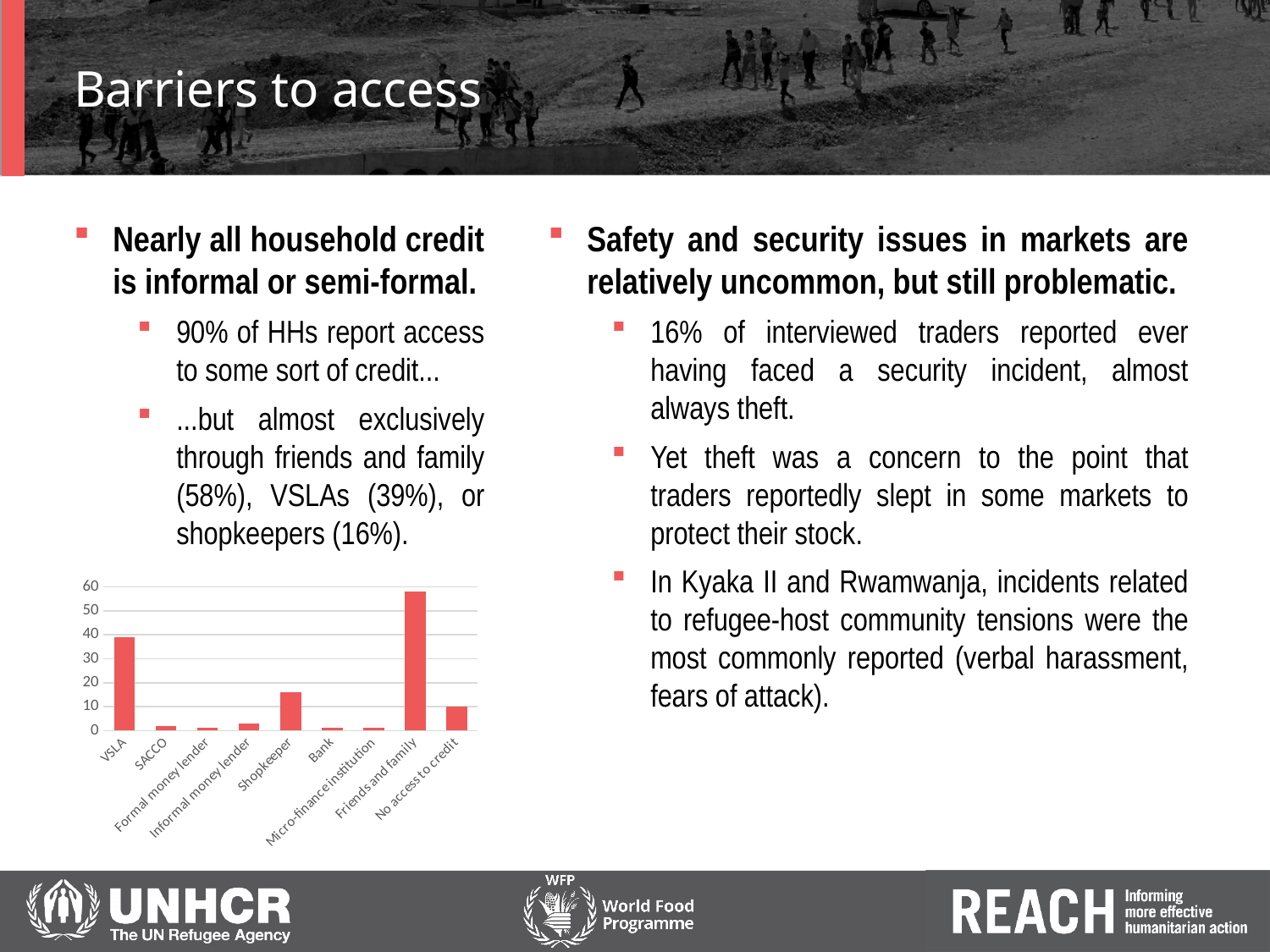
Which is larger in the chart, the value for Friends and family or the value for VSLA? Friends and family Is the value for No access to credit in the chart greater or less than 20? less Which is larger in the chart, the value for VSLA or the value for Shopkeeper? VSLA Is the value for VSLA in the chart greater or less than 30? greater What is the highest value shown on the y axis of the chart? 60 What kind of chart is shown on the slide? bar chart Is the value for Shopkeeper in the chart greater or less than 10? greater Which is larger in the chart, the value for Shopkeeper or the value for Bank? Shopkeeper How many categories are shown on the x axis of the chart? 9 Which category has the highest bar in the chart? Friends and family